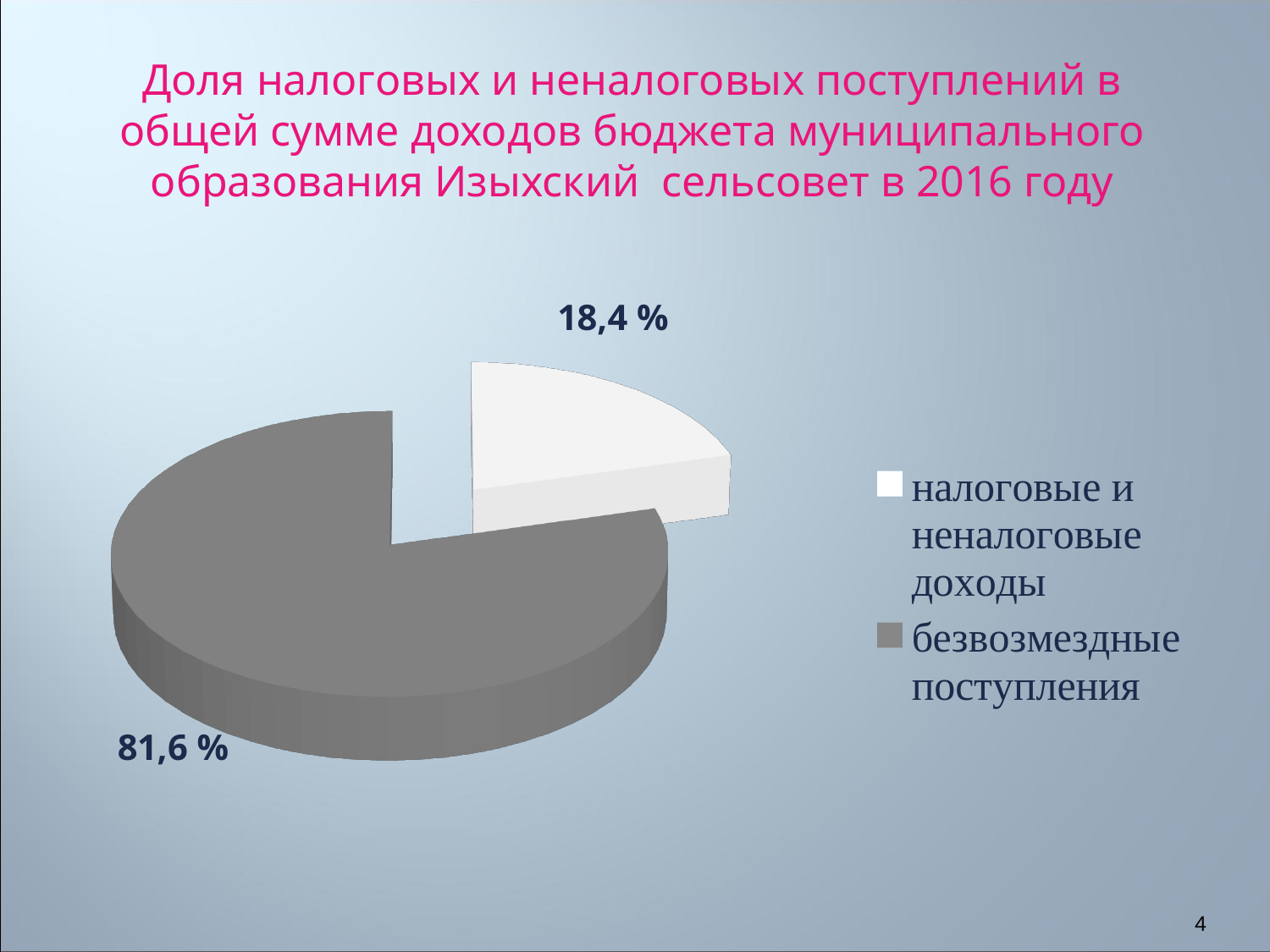
What is the difference in percentage points between безвозмездные поступления and налоговые и неналоговые доходы? 63,2 What share of the pie is labelled for безвозмездные поступления? 81,6 % What kind of chart is shown on the slide? pie chart What colour is the slice for безвозмездные поступления? grey Which category has the largest share of the pie? безвозмездные поступления What share of the pie is labelled for налоговые и неналоговые доходы? 18,4 % Which category has the smallest share of the pie? налоговые и неналоговые доходы How many entries does the legend list? 2 How many slices does the pie chart have? 2 Which year does the chart title refer to? 2016 Which is larger: the share for налоговые и неналоговые доходы or the share for безвозмездные поступления? безвозмездные поступления